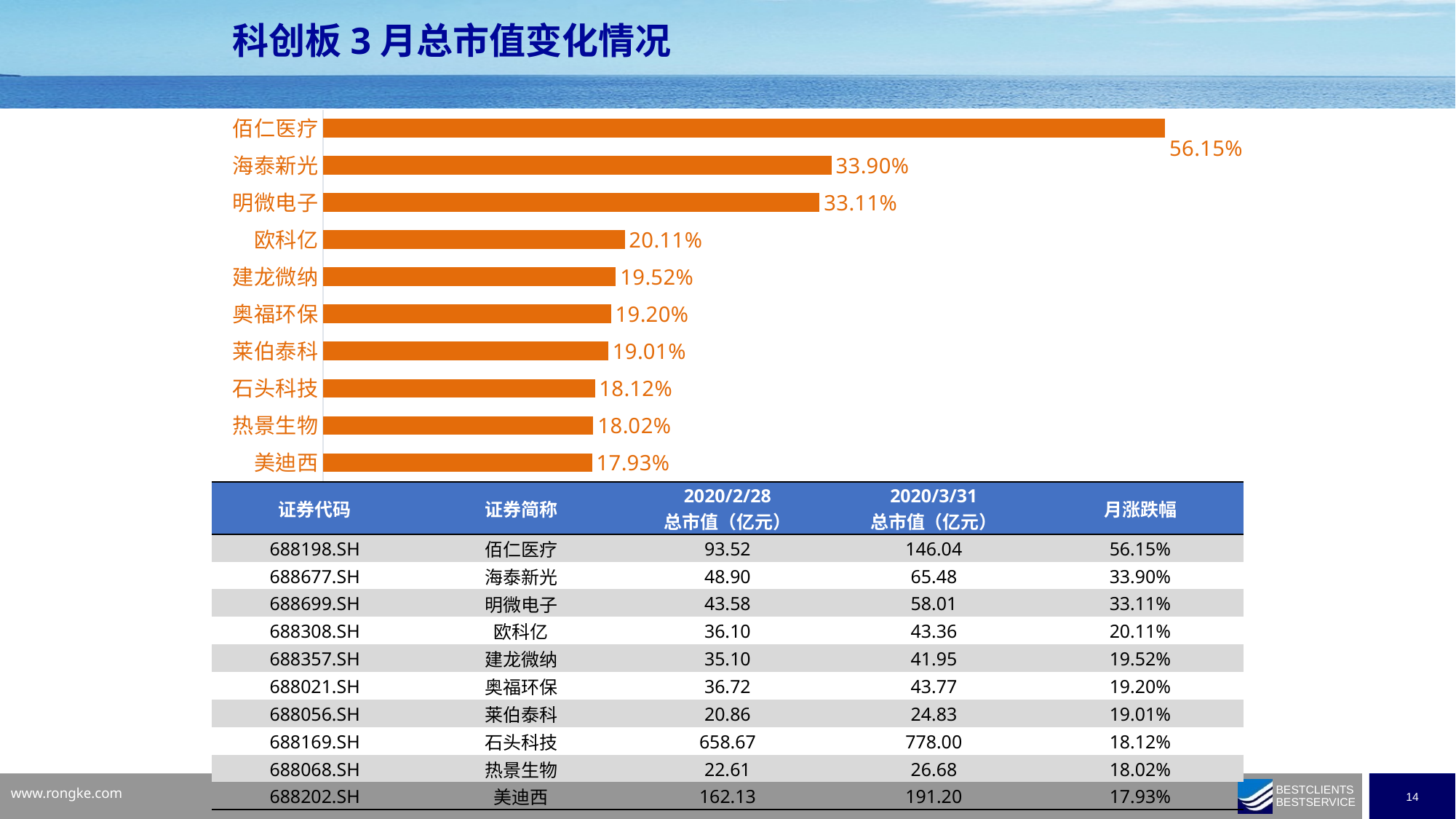
What kind of chart is shown on the slide? bar chart Which category has the lowest value in the bar chart? 美迪西 What is the value shown for 石头科技 in the bar chart? 18.12% What is the value shown for 佰仁医疗 in the bar chart? 56.15% What is the title of the slide containing the chart? 科创板 3 月总市值变化情况 What is the difference between the values for 佰仁医疗 and 海泰新光 in the bar chart? 22.25% What is the difference between the values for 欧科亿 and 美迪西 in the bar chart? 2.18% Which has a larger value in the bar chart, 海泰新光 or 明微电子? 海泰新光 Which category has the highest value in the bar chart? 佰仁医疗 Which has a larger value in the bar chart, 建龙微纳 or 热景生物? 建龙微纳 How many categories are shown in the bar chart? 10 What is the value shown for 奥福环保 in the bar chart? 19.20%